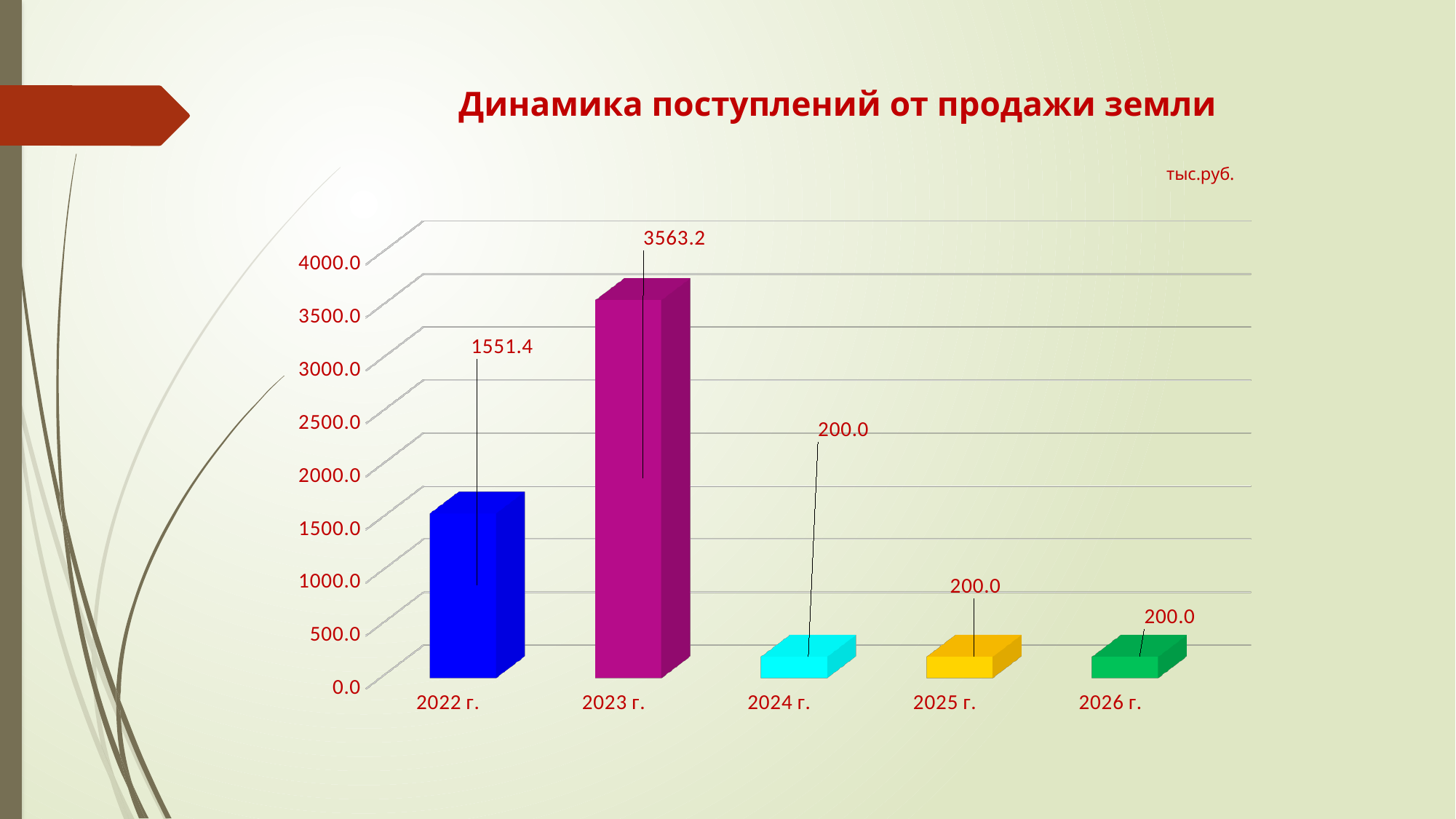
Is the value for 2026 г. greater or less than 500.0? less What is the value for 2025 г.? 200.0 What unit is indicated in the top right corner of the chart? тыс.руб. Is the value for 2023 г. greater or less than 3000.0? greater Which year has the highest value? 2023 г. What is the title of the chart? Динамика поступлений от продажи земли What is the value for 2023 г.? 3563.2 What is the value for 2022 г.? 1551.4 Which is larger, the value for 2022 г. or the value for 2024 г.? 2022 г. What kind of chart is shown on the slide? bar chart What is the difference between the values for 2023 г. and 2022 г.? 2011.8 How many years are shown on the x axis? 5